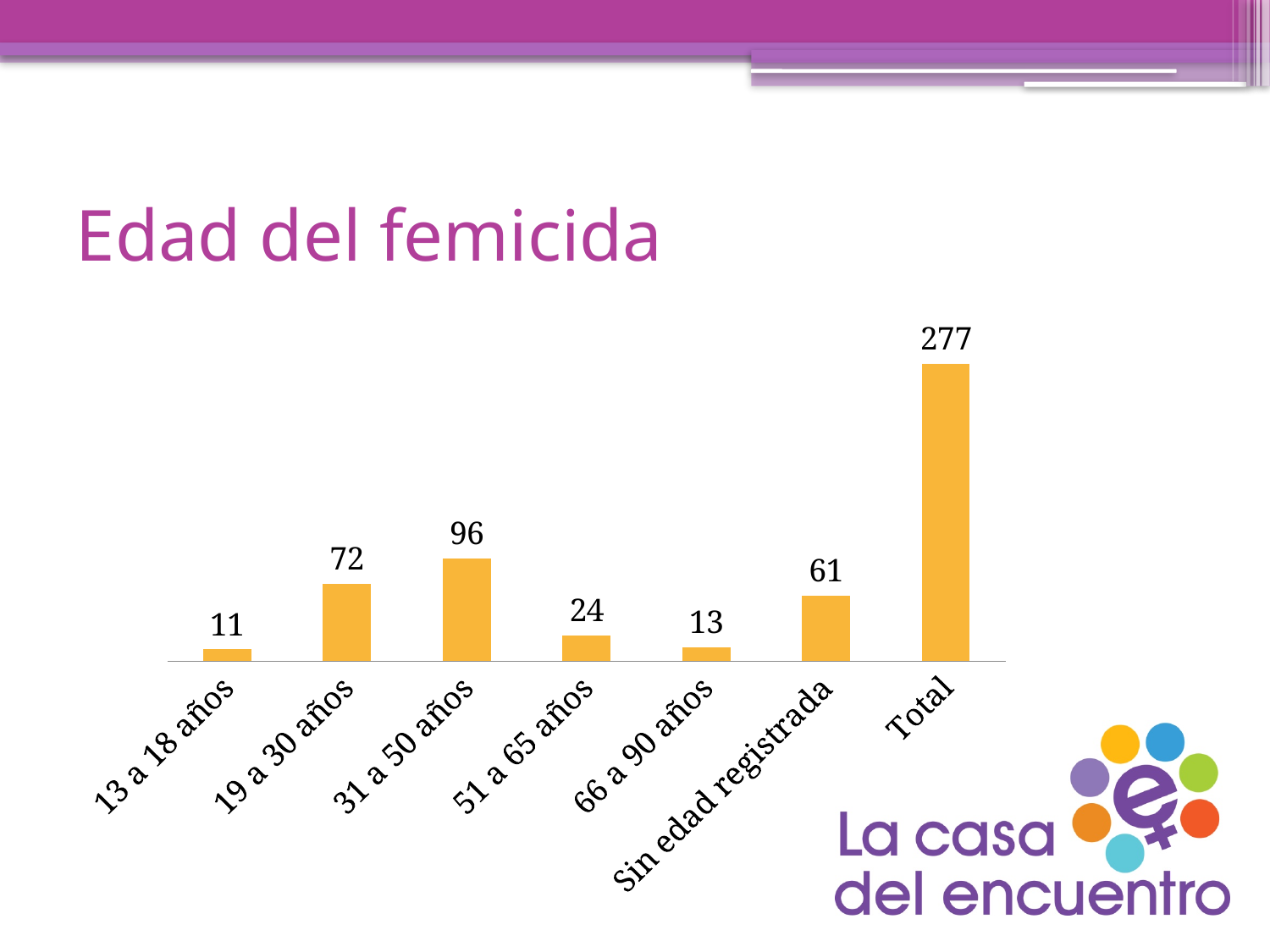
Which is larger, the value for '66 a 90 años' or the value for '51 a 65 años'? 51 a 65 años What is the value for 'Sin edad registrada'? 61 Which category has the lowest value? 13 a 18 años What is the value for the '31 a 50 años' category? 96 What is the value shown for 'Total'? 277 What is the difference between the values for '19 a 30 años' and '51 a 65 años'? 48 What is the title of the slide containing the chart? Edad del femicida How many categories are shown on the x axis? 7 Excluding the Total bar, which age category has the highest value? 31 a 50 años What colour are the bars in the chart? orange What kind of chart is shown on the slide? bar chart What is the value for the '13 a 18 años' category? 11